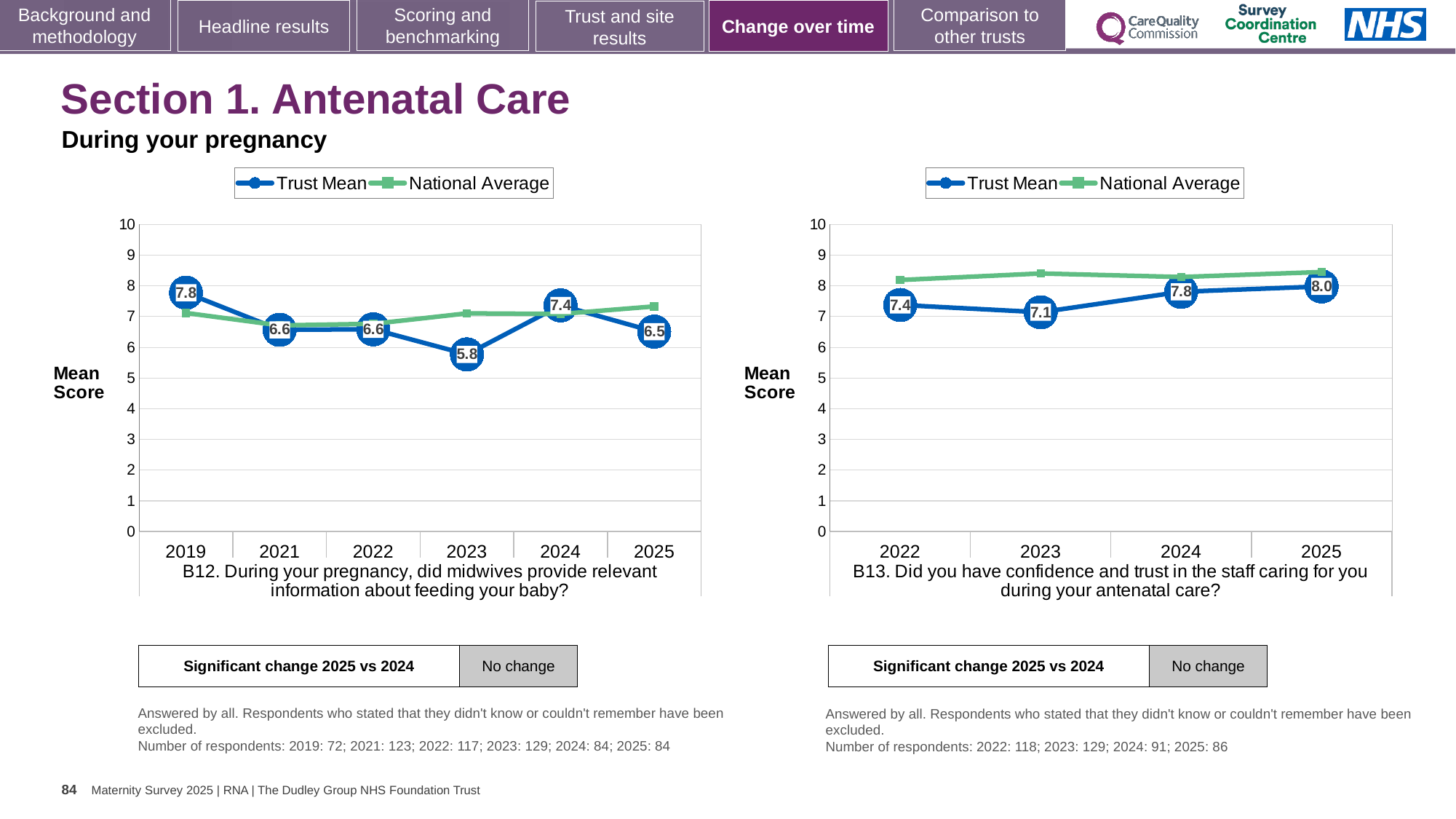
In the B13 chart (right), how many series does the legend list? 2 In the B12 chart (left), what is the Trust Mean for 2023? 5.8 In the B13 chart (right), what is the Trust Mean for 2025? 8.0 In the B12 chart (left), which year has the highest Trust Mean? 2019 In the B12 chart (left), what is the difference between the Trust Mean for 2024 and 2025? 0.9 In the B13 chart (right), is the Trust Mean for 2024 larger or smaller than the Trust Mean for 2023? larger What kind of chart is the B13 chart (right)? line chart In the B13 chart (right), is the National Average for 2023 greater or less than 8? greater In the B12 chart (left), how many years are shown on the x axis? 6 In the B13 chart (right), which year has the lowest Trust Mean? 2023 In the B12 chart (left), which year has the lowest Trust Mean? 2023 In the B12 chart (left), what is the Trust Mean for 2019? 7.8